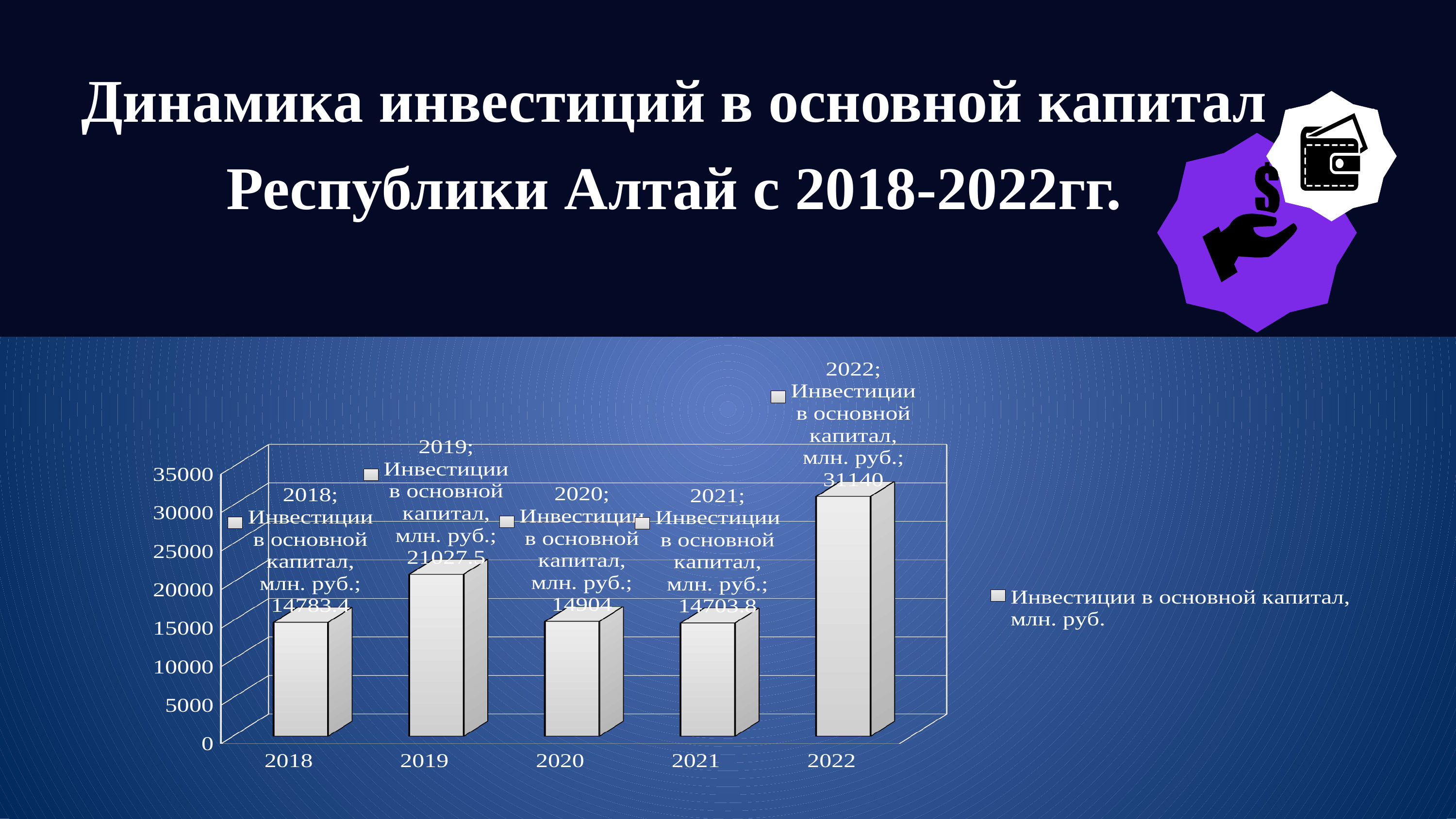
Which year has the highest value of investments in fixed capital? 2022 What type of chart is shown on the slide? bar chart Which year has a larger value, 2020 or 2021? 2020 What is the value of investments in fixed capital for 2022? 31140 How many years are shown on the x axis of the chart? 5 What is the value of investments in fixed capital for 2019? 21027.5 What is the value of investments in fixed capital for 2018? 14783.4 What is the value of investments in fixed capital for 2021? 14703.8 What is the difference between the values for 2022 and 2019? 10112.5 What is the legend entry of the chart? Инвестиции в основной капитал, млн. руб. What is the value of investments in fixed capital for 2020? 14904 Which year has the lowest value of investments in fixed capital? 2021